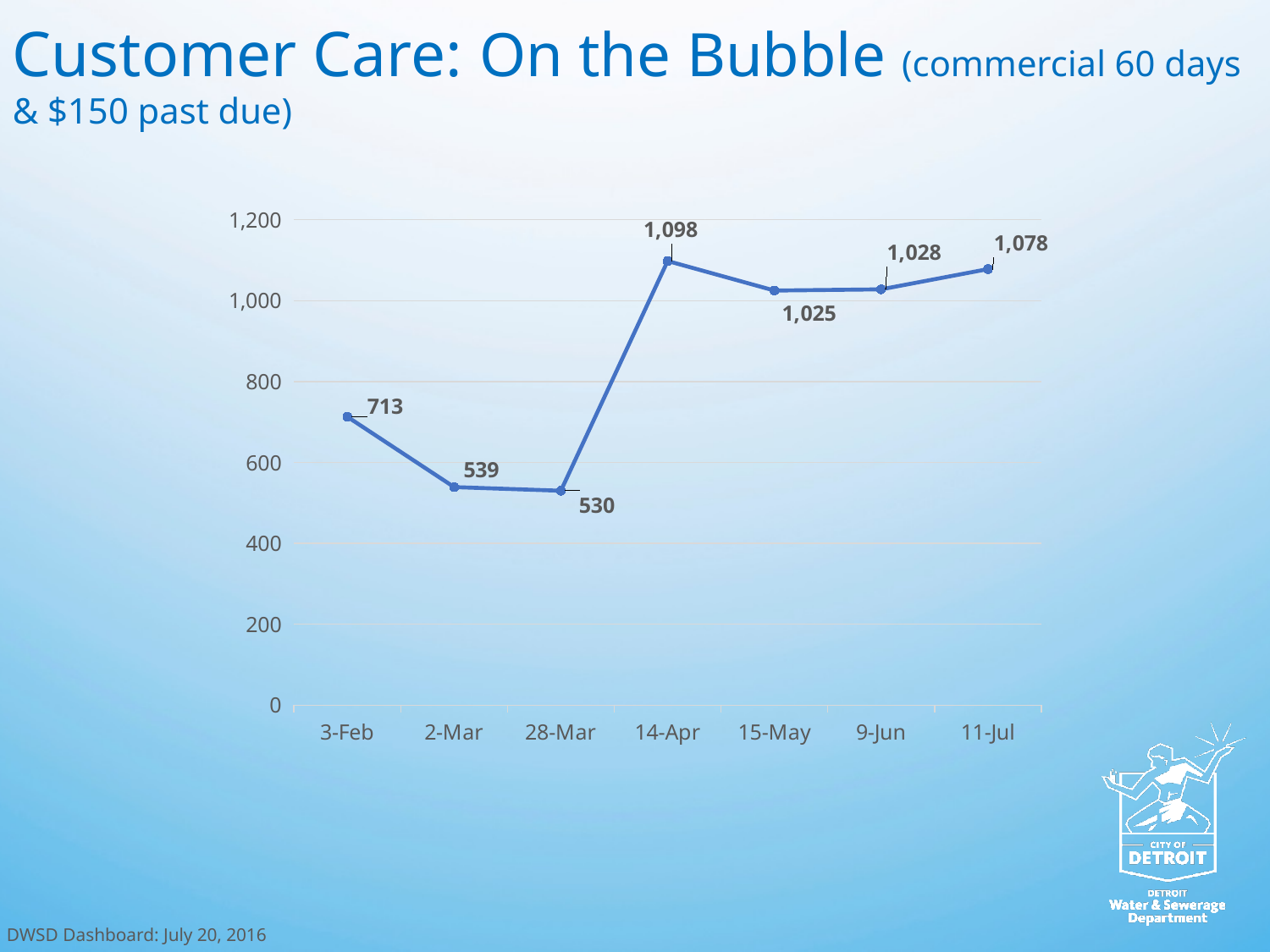
What is the value for 3-Feb? 713 What is the value for 14-Apr? 1,098 Which date has the lowest value? 28-Mar Is the value for 15-May greater or less than 1,000? greater What kind of chart is shown on the slide? line chart Which date has the highest value? 14-Apr Do the values rise or fall from 28-Mar to 14-Apr? rise What is the value for 11-Jul? 1,078 Which is larger, the value for 3-Feb or the value for 2-Mar? 3-Feb What is the difference between the values for 9-Jun and 15-May? 3 How many data points are plotted on the chart? 7 What is the difference between the values for 14-Apr and 28-Mar? 568